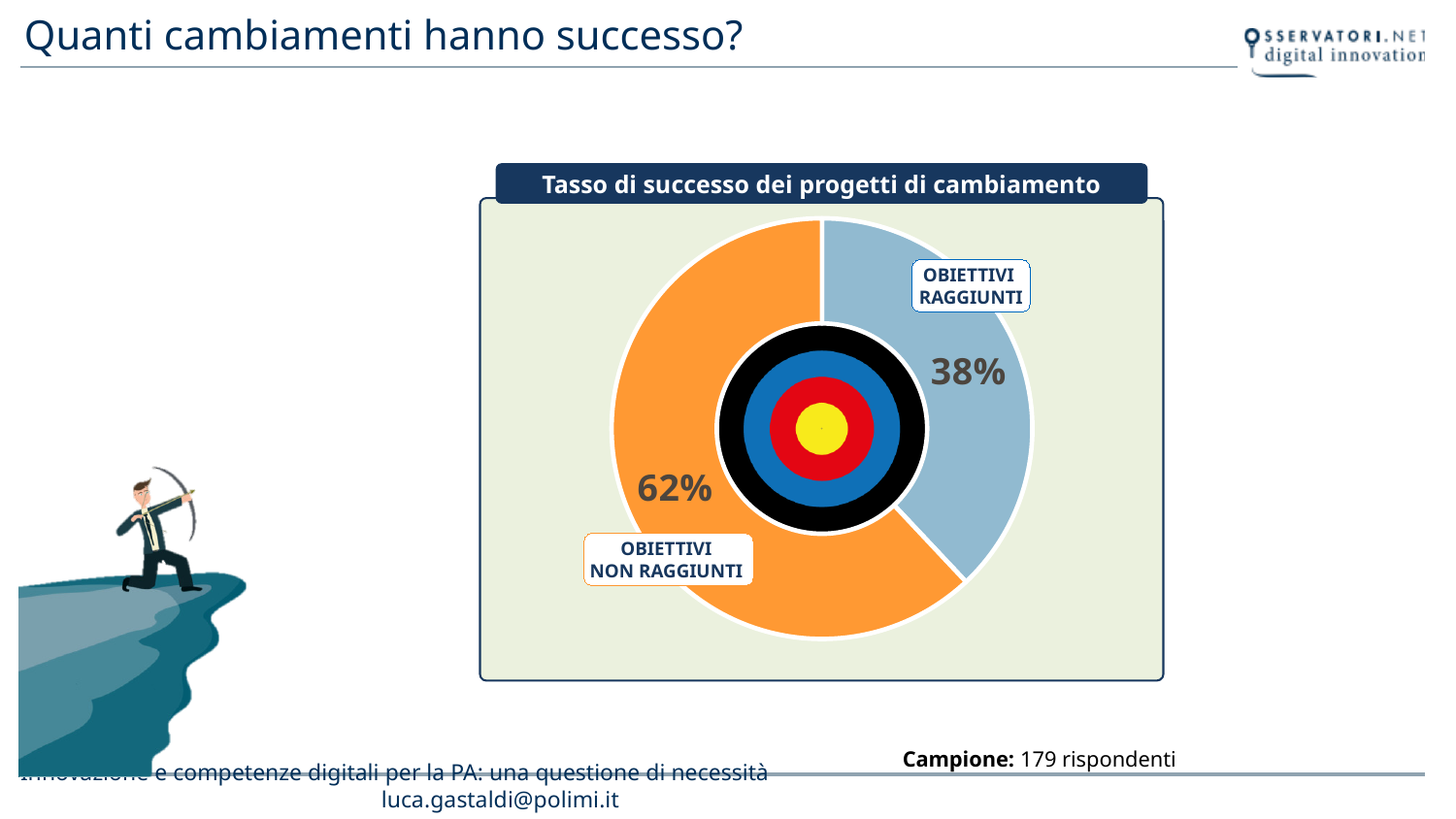
What share of the chart is labelled OBIETTIVI RAGGIUNTI? 38% What share of the chart is labelled OBIETTIVI NON RAGGIUNTI? 62% What is the total of the two shares shown in the chart? 100% What is the title of the chart? Tasso di successo dei progetti di cambiamento How many categories does the chart show? 2 Which category has the largest share in the chart? OBIETTIVI NON RAGGIUNTI Which category has the smallest share in the chart? OBIETTIVI RAGGIUNTI Is the share for OBIETTIVI RAGGIUNTI greater or less than 50%? less What kind of chart is shown on the slide? Pie chart (doughnut) Which is larger, the share for OBIETTIVI RAGGIUNTI or the share for OBIETTIVI NON RAGGIUNTI? OBIETTIVI NON RAGGIUNTI What is the difference in percentage points between OBIETTIVI NON RAGGIUNTI and OBIETTIVI RAGGIUNTI? 24 percentage points What colour is the OBIETTIVI NON RAGGIUNTI slice? Orange